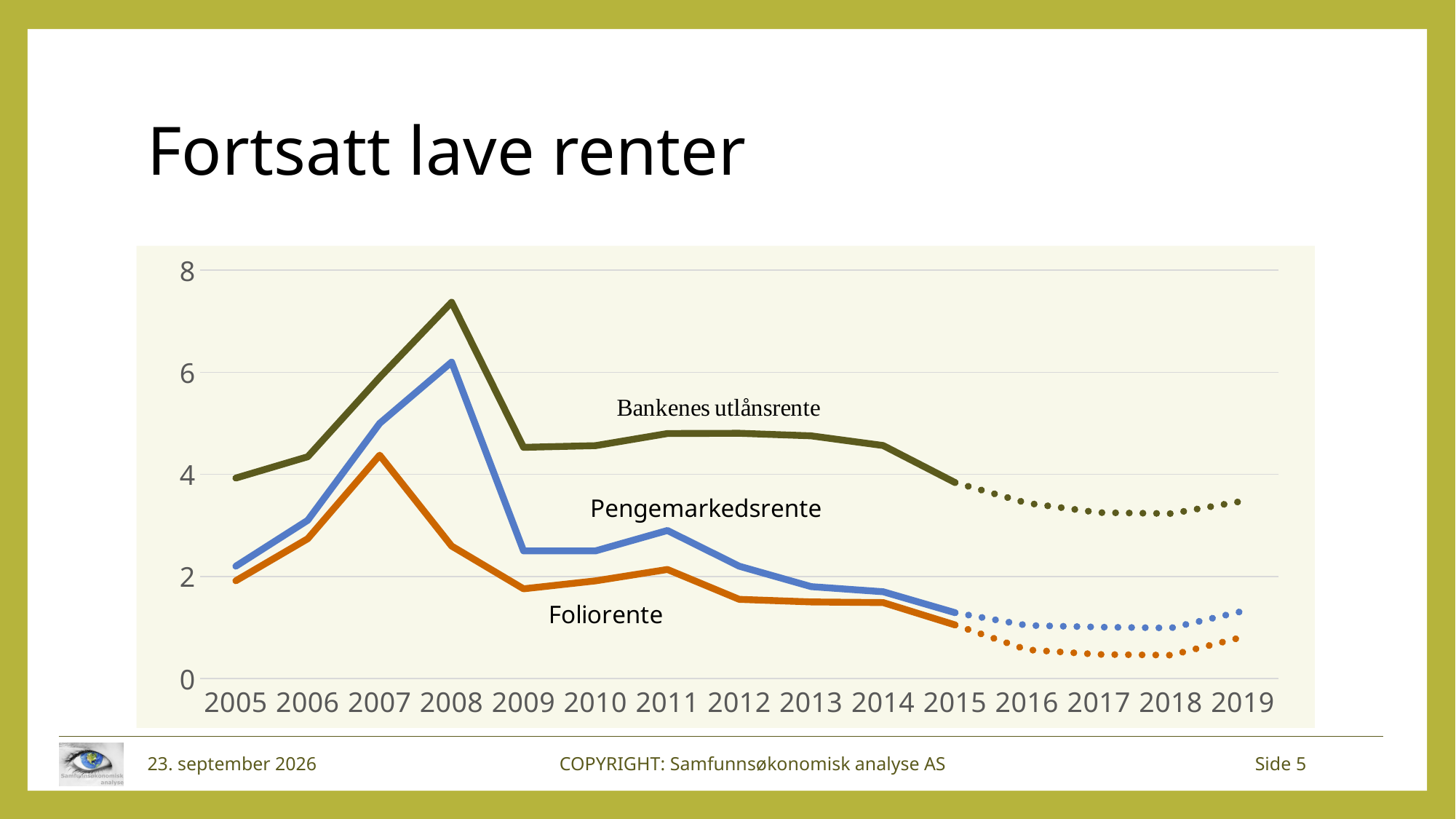
Is the value for Bankenes utlånsrente in 2008 greater or less than 6? greater Is the value for Foliorente in 2018 greater or less than 1? less How many years are shown on the x axis of the chart? 15 In which year does Bankenes utlånsrente reach its highest value? 2008 In which year does Pengemarkedsrente reach its highest value? 2008 Is the value for Pengemarkedsrente in 2009 greater or less than 4? less What kind of chart is shown on the slide? line chart In which year does Foliorente reach its highest value? 2007 How many series are plotted in the chart? 3 What is the title of the slide above the chart? Fortsatt lave renter Does Bankenes utlånsrente rise or fall from 2011 to 2015? fall In 2015, which is higher: Bankenes utlånsrente or Foliorente? Bankenes utlånsrente